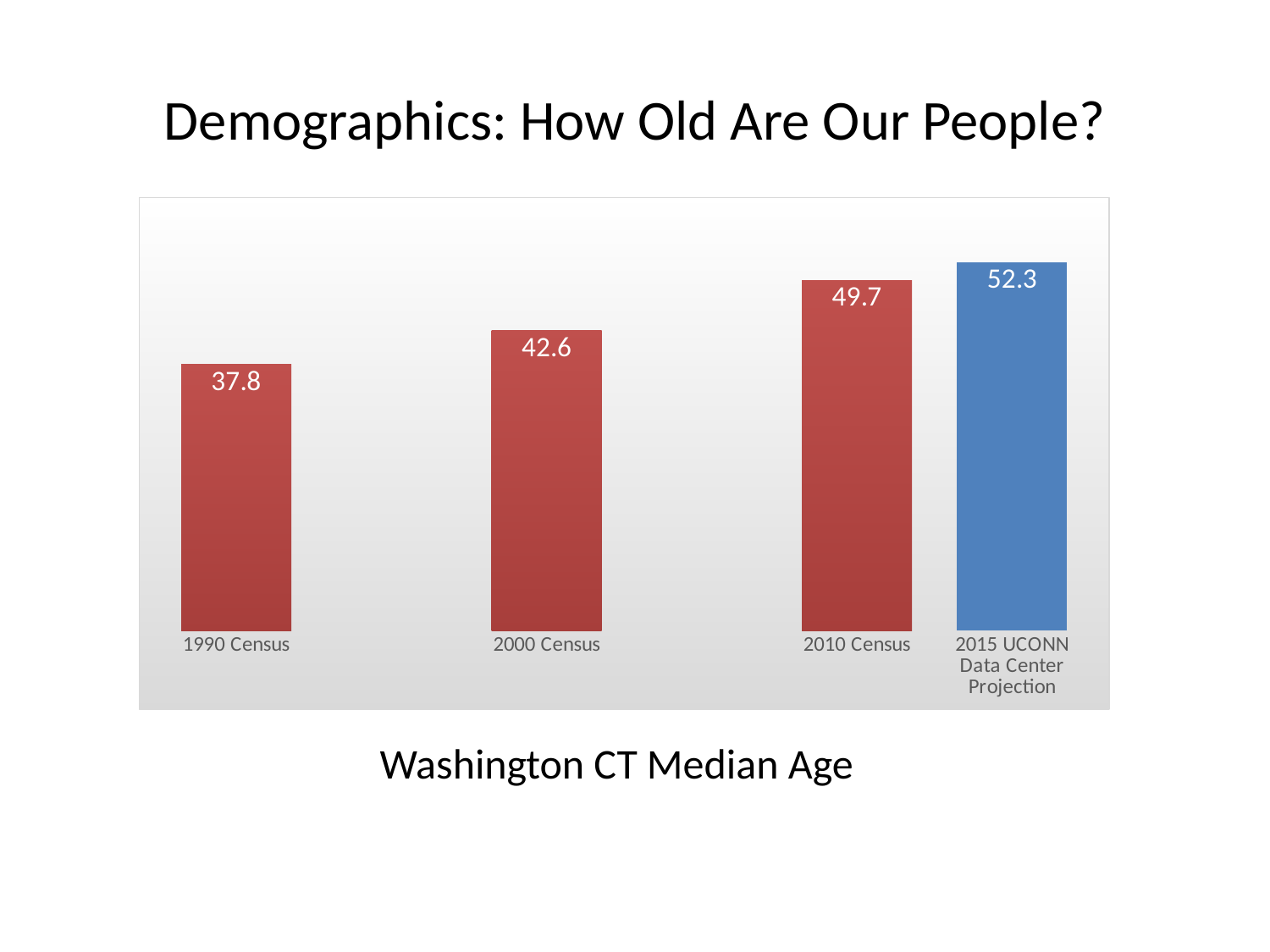
Which is larger, the median age for the 2000 Census or the 2010 Census? 2010 Census What is the median age shown for the 2015 UCONN Data Center Projection? 52.3 Do the median age values rise or fall from left to right across the chart? Rise What is the median age shown for the 2010 Census? 49.7 What is the difference between the 2010 Census median age and the 1990 Census median age? 11.9 Which category has the lowest median age? 1990 Census How many categories are shown in the chart? 4 Which category has the highest median age? 2015 UCONN Data Center Projection What kind of chart is shown on the slide? Bar chart What is the difference between the 2015 UCONN Data Center Projection and the 2010 Census median age? 2.6 What is the median age shown for the 1990 Census? 37.8 What is the median age shown for the 2000 Census? 42.6